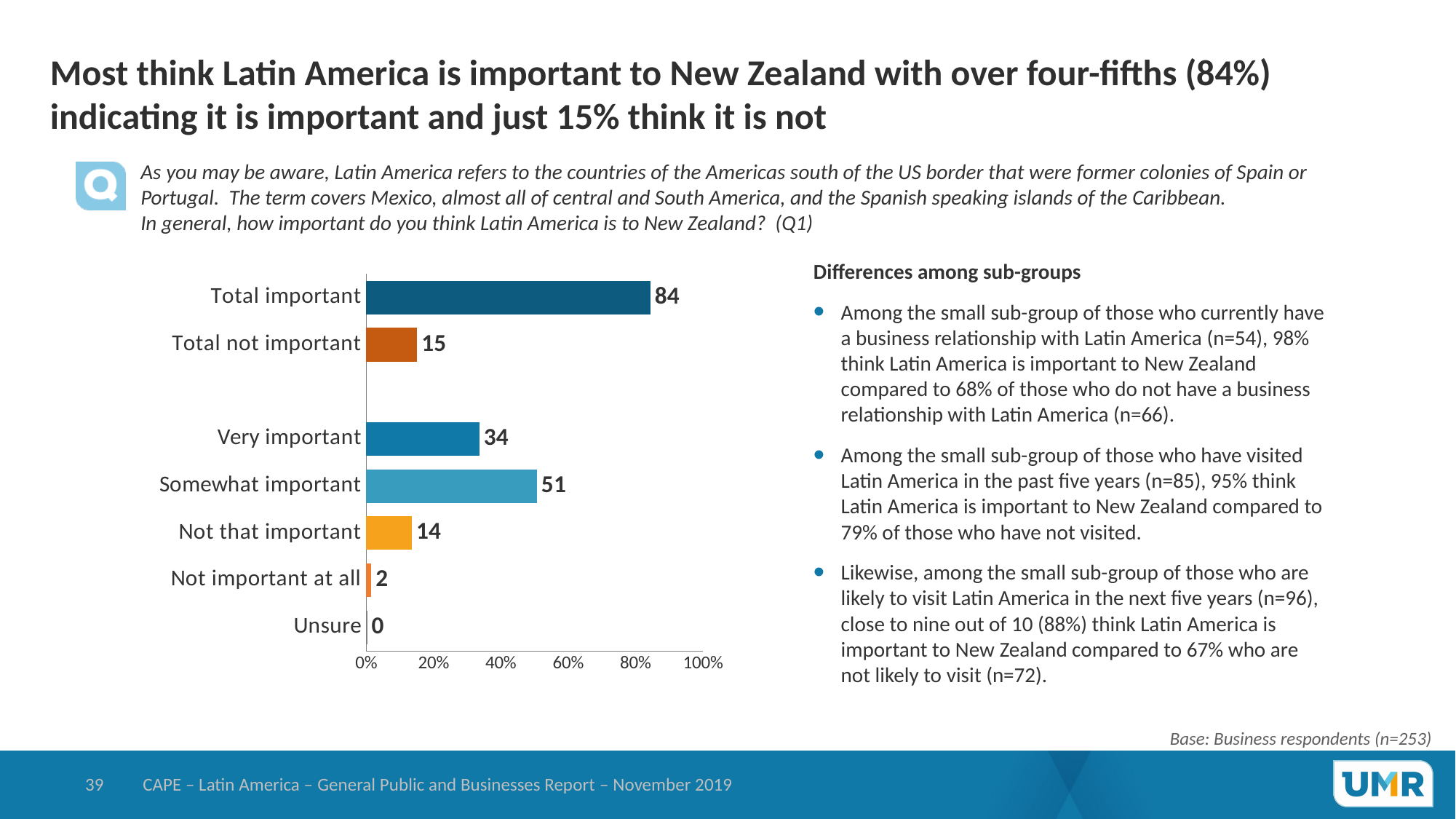
Which category has the lowest value? Unsure Which category has the highest value? Total important What is the value for Total important? 84 What is the highest value shown on the x axis? 100% What is the value for Unsure? 0 What is the value for Not that important? 14 What is the difference between Somewhat important and Very important? 17 What is the difference between Total important and Total not important? 69 What is the value for Somewhat important? 51 Which is larger, Very important or Not that important? Very important How many categories are shown on the chart? 7 What kind of chart is shown on the slide? Bar chart